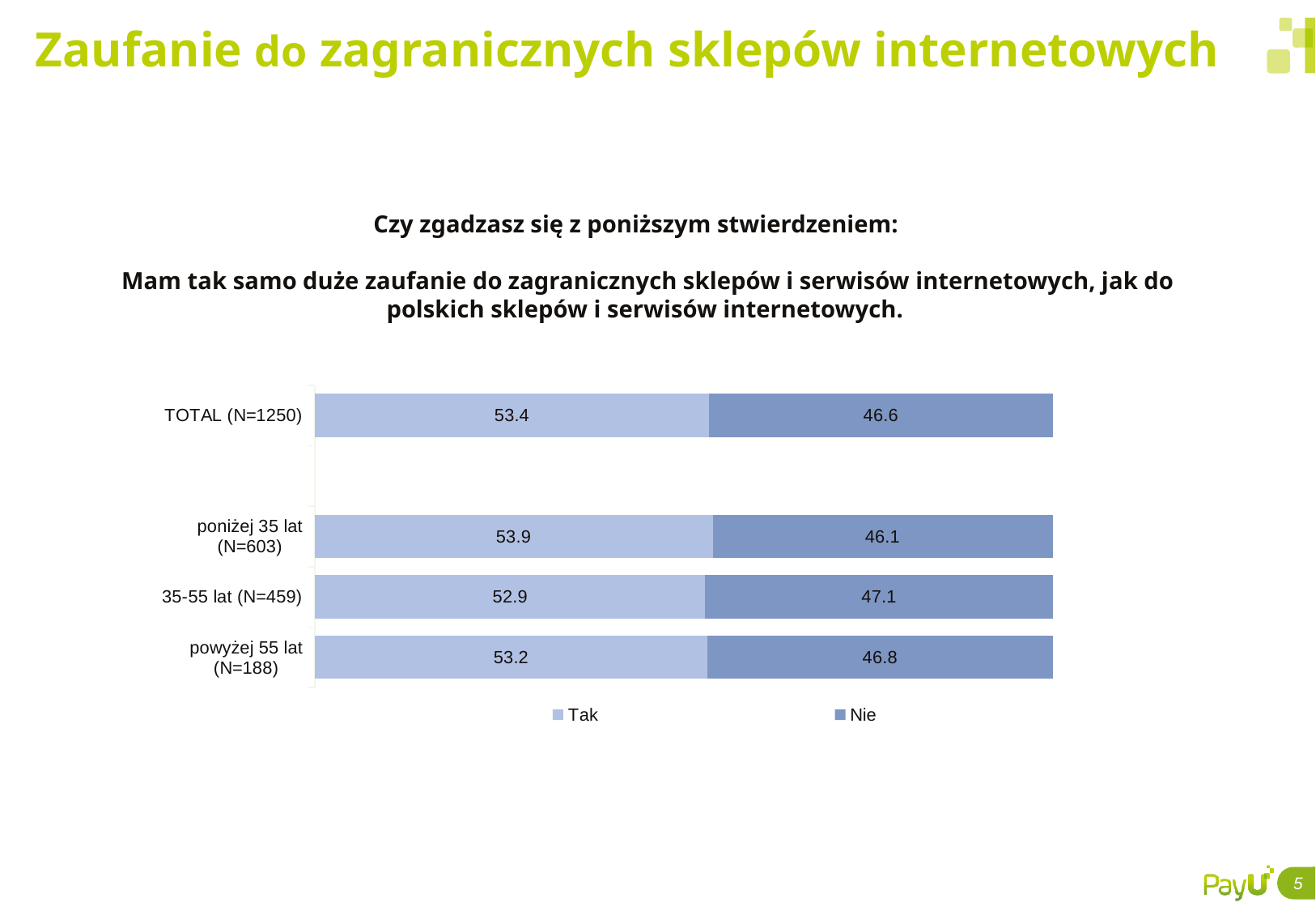
What is the difference between the 'Tak' and 'Nie' values for TOTAL (N=1250)? 6.8 What is the 'Nie' value for 35-55 lat (N=459)? 47.1 Which category has the lowest 'Tak' value? 35-55 lat (N=459) What is the 'Nie' value for poniżej 35 lat (N=603)? 46.1 What is the 'Tak' value for TOTAL (N=1250)? 53.4 How many series does the legend list? 2 What is the 'Tak' value for powyżej 55 lat (N=188)? 53.2 What kind of chart is shown on the slide? Stacked bar chart How many categories are shown on the chart? 4 What is the total of the stacked bar for 35-55 lat (N=459)? 100 Is the 'Nie' value larger for 35-55 lat (N=459) or for poniżej 35 lat (N=603)? 35-55 lat (N=459) Which category has the highest 'Tak' value? poniżej 35 lat (N=603)